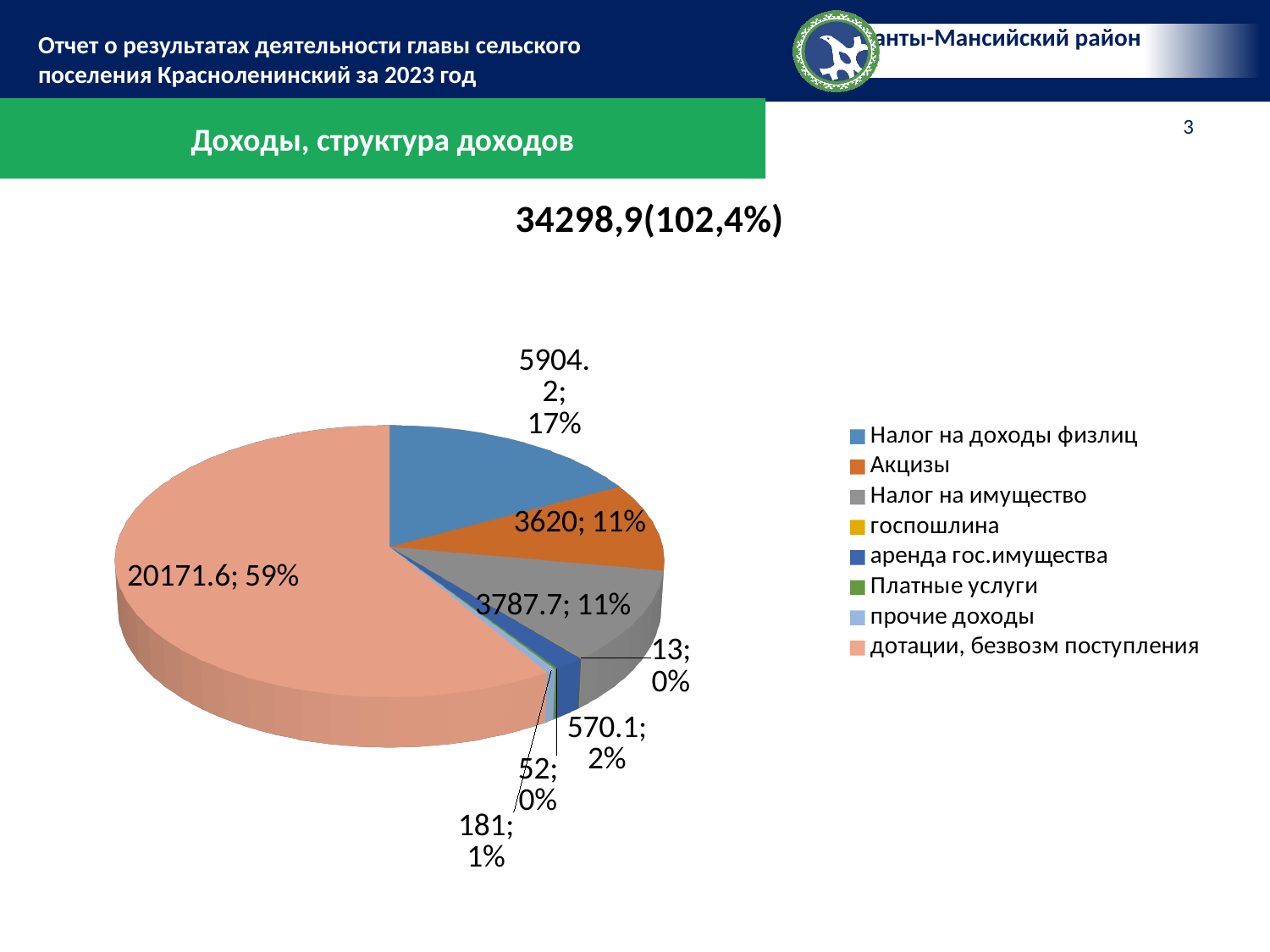
How many slices does the pie chart have? 8 What value is shown for Налог на доходы физлиц? 5904.2 What is the title shown above the pie chart? 34298,9(102,4%) Which category has the largest slice of the pie? дотации, безвозм поступления What value is shown for Акцизы? 3620 What type of chart is shown on the slide? pie chart What share of the pie does дотации, безвозм поступления represent? 59% What value is shown for аренда гос.имущества? 570.1 How many entries does the legend list? 8 Which is larger, the value for прочие доходы or the value for Платные услуги? прочие доходы Which category has the smallest value in the pie chart? госпошлина What is the difference between the values for Налог на имущество and Акцизы? 167.7